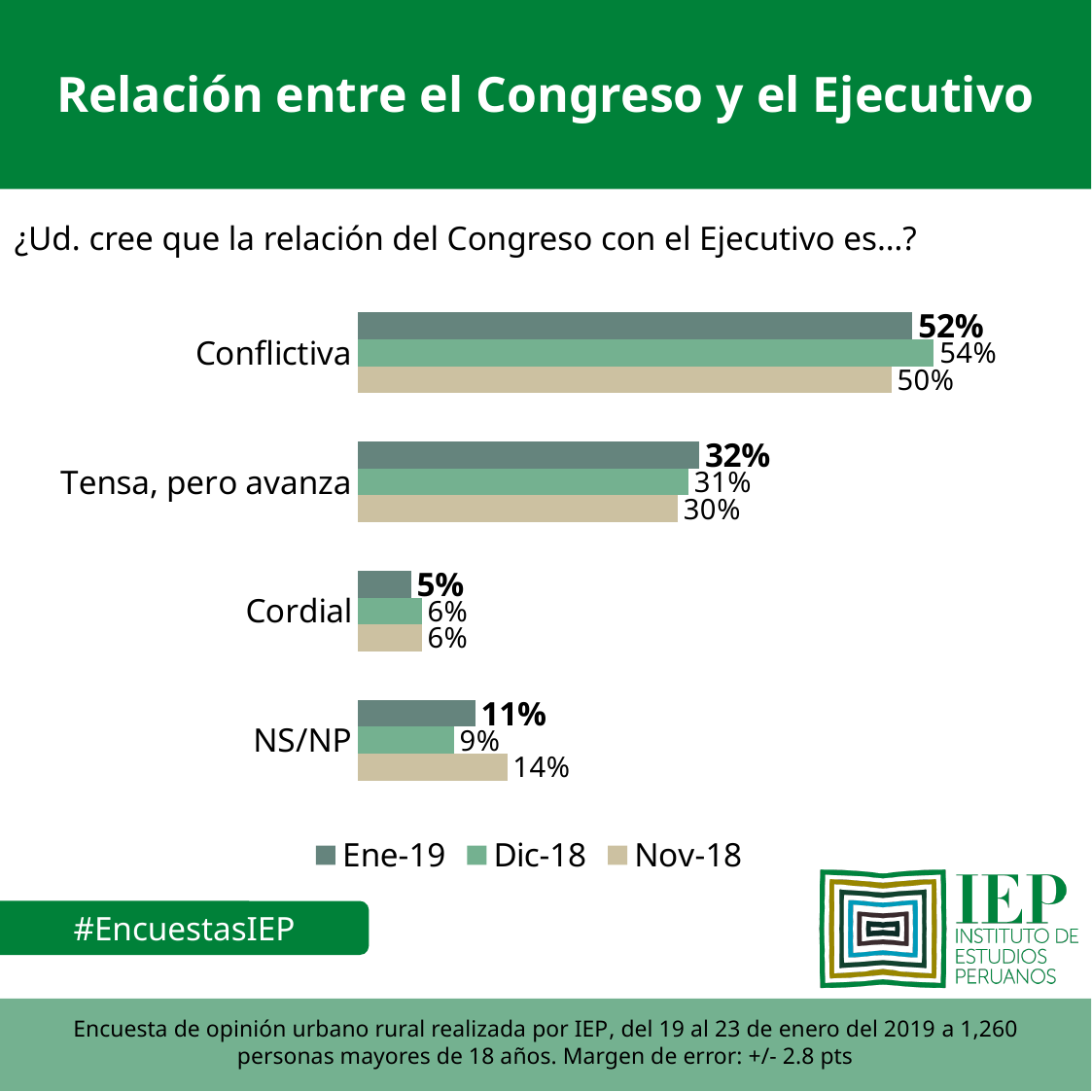
What is the title of the slide? Relación entre el Congreso y el Ejecutivo What is the value for NS/NP in the Dic-18 series? 9% Which is larger for NS/NP: the Ene-19 value or the Nov-18 value? Nov-18 Which category has the highest value in the Ene-19 series? Conflictiva What is the value for Tensa, pero avanza in the Nov-18 series? 30% What is the value for Cordial in the Ene-19 series? 5% What kind of chart is shown on the slide? Bar chart How many categories are shown on the chart? 4 How many series does the legend list? 3 What is the difference between the Dic-18 and Nov-18 values for Conflictiva? 4% What is the value for Conflictiva in the Ene-19 series? 52% Which category has the lowest value in the Nov-18 series? Cordial